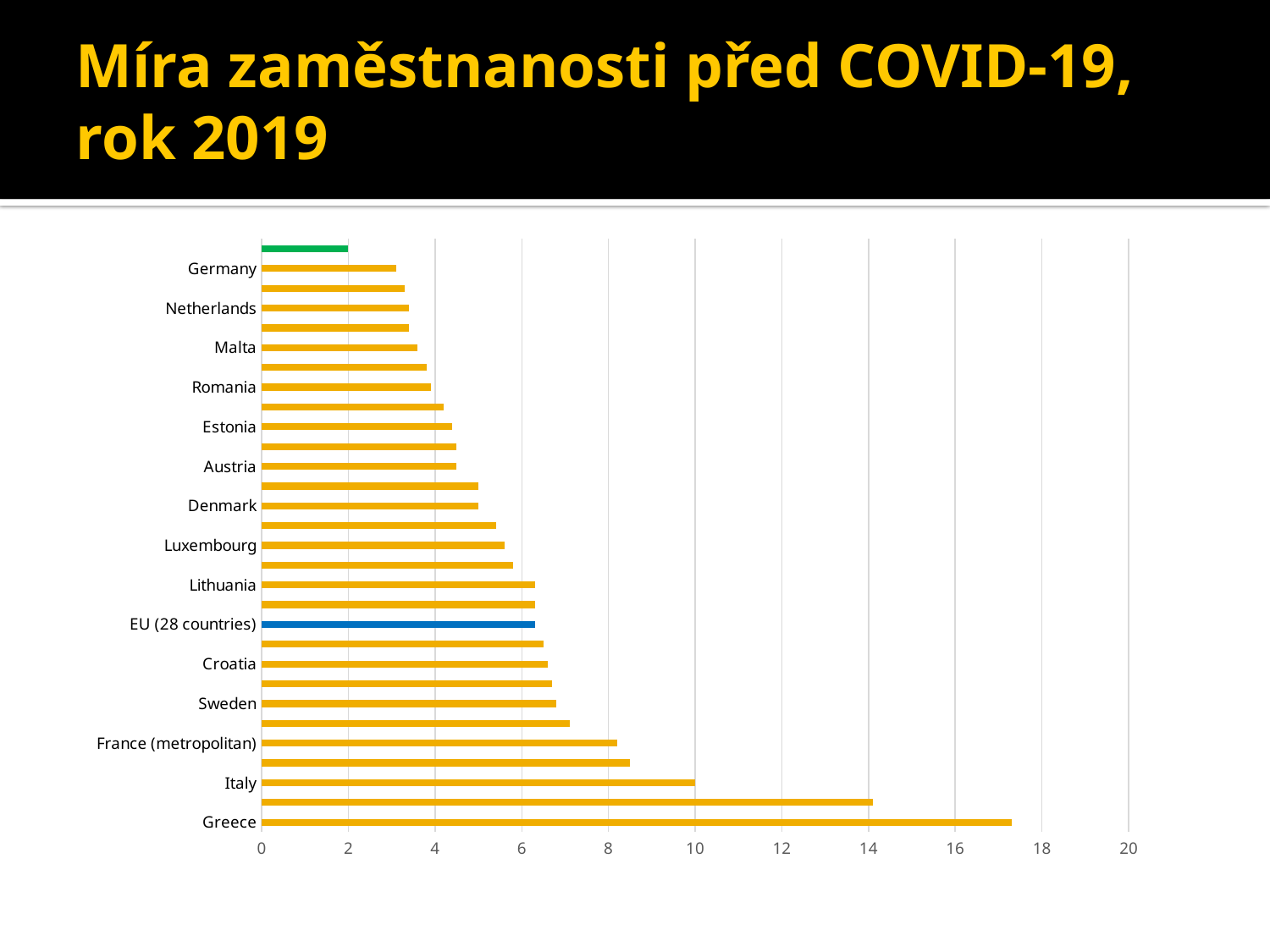
Is the value for Denmark greater or less than 6? less Is the value for Greece greater or less than 16? greater Is the value for Lithuania greater or less than 4? greater Which has the larger value, Germany or Malta? Malta What kind of chart is shown on the slide? bar chart Which labeled country has the shortest bar in the chart? Germany Which has the larger value, Italy or Sweden? Italy What colour is the bar for EU (28 countries)? blue Which labeled country has the longest bar in the chart? Greece